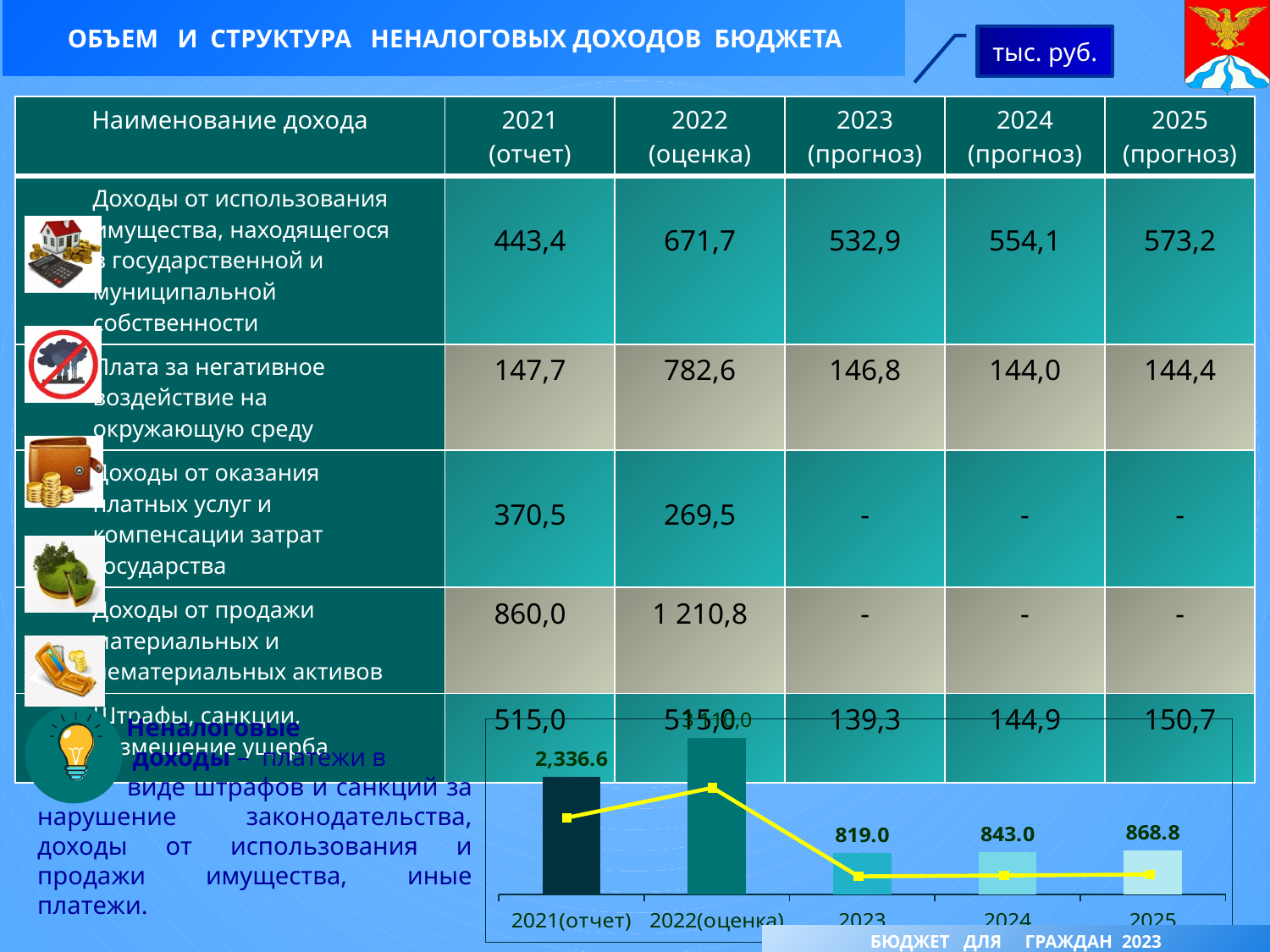
In the bar chart at the bottom of the slide, what is the difference between the 2025 value and the 2024 value? 25.8 In the bar chart at the bottom of the slide, which is larger: the value for 2021(отчет) or the value for 2025? 2021(отчет) In the bar chart at the bottom of the slide, do the values rise or fall from 2023 to 2025? Rise How many years (categories) are plotted in the bar chart at the bottom of the slide? 5 In the bar chart at the bottom of the slide, which year has the tallest bar? 2022(оценка) What is the value shown for 2021(отчет) in the bar chart at the bottom of the slide? 2,336.6 In the bar chart at the bottom of the slide, what is the difference between the 2024 value and the 2023 value? 24.0 In the bar chart at the bottom of the slide, which year has the lowest value? 2023 What is the value shown for 2024 in the bar chart at the bottom of the slide? 843.0 What kind of chart is shown at the bottom of the slide? Bar chart with a line overlay What is the value shown for 2023 in the bar chart at the bottom of the slide? 819.0 What is the value shown for 2025 in the bar chart at the bottom of the slide? 868.8